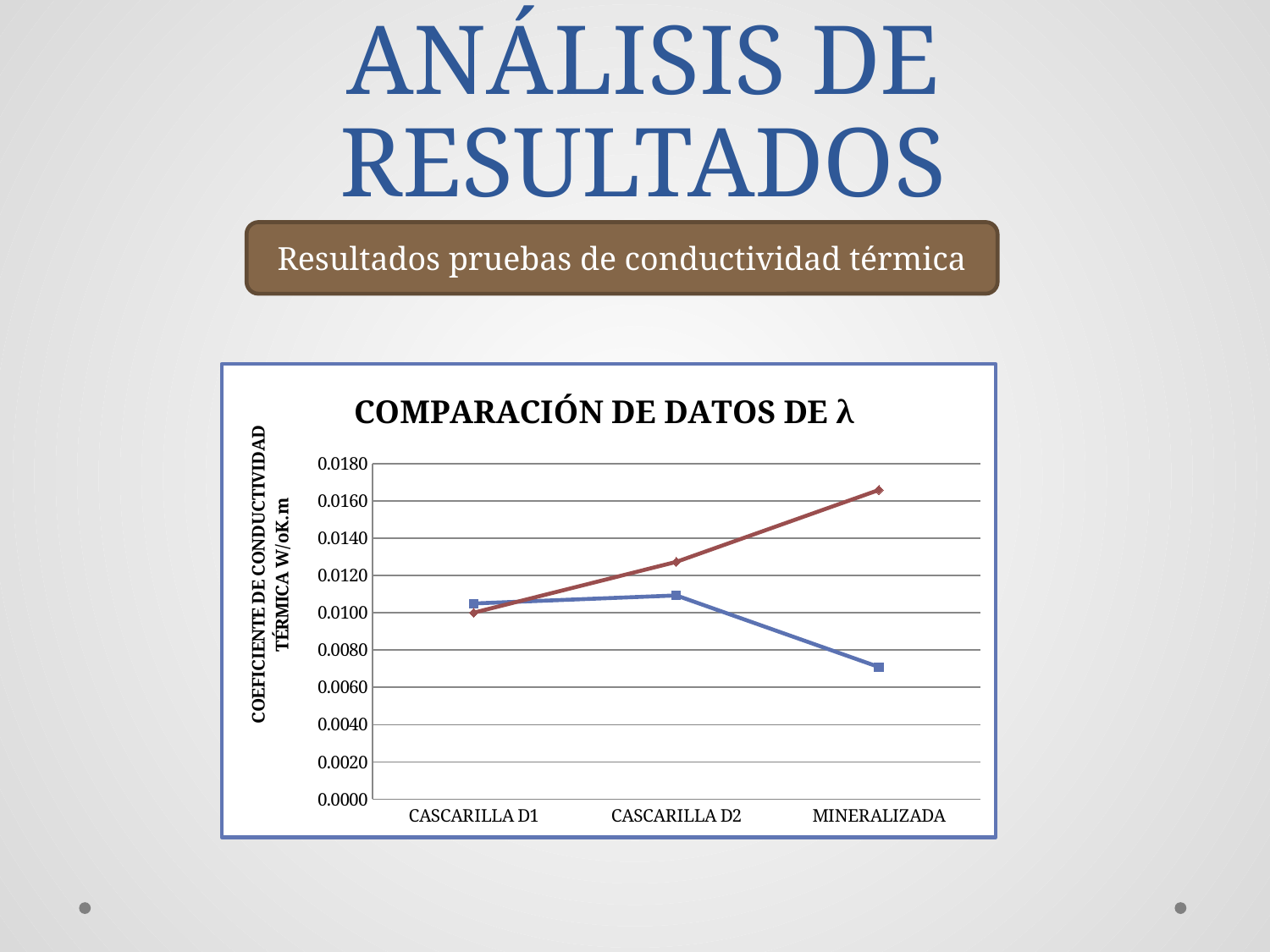
For which category is the blue line lowest? MINERALIZADA For which category is the red line highest? MINERALIZADA For which category is the red line lowest? CASCARILLA D1 What is the title of the chart? COMPARACIÓN DE DATOS DE λ What is the y-axis title of the chart? COEFICIENTE DE CONDUCTIVIDAD TÉRMICA W/oK.m How many categories are shown on the x axis of the chart? 3 Is the value of the red line at MINERALIZADA greater or less than 0.0140? greater Is the value of the blue line at MINERALIZADA greater or less than 0.0080? less Does the blue line rise or fall from CASCARILLA D2 to MINERALIZADA? Falls At MINERALIZADA, which line has the larger value, the red line or the blue line? Red line Does the red line rise or fall from CASCARILLA D1 to MINERALIZADA? Rises What kind of chart is shown on the slide? Line chart